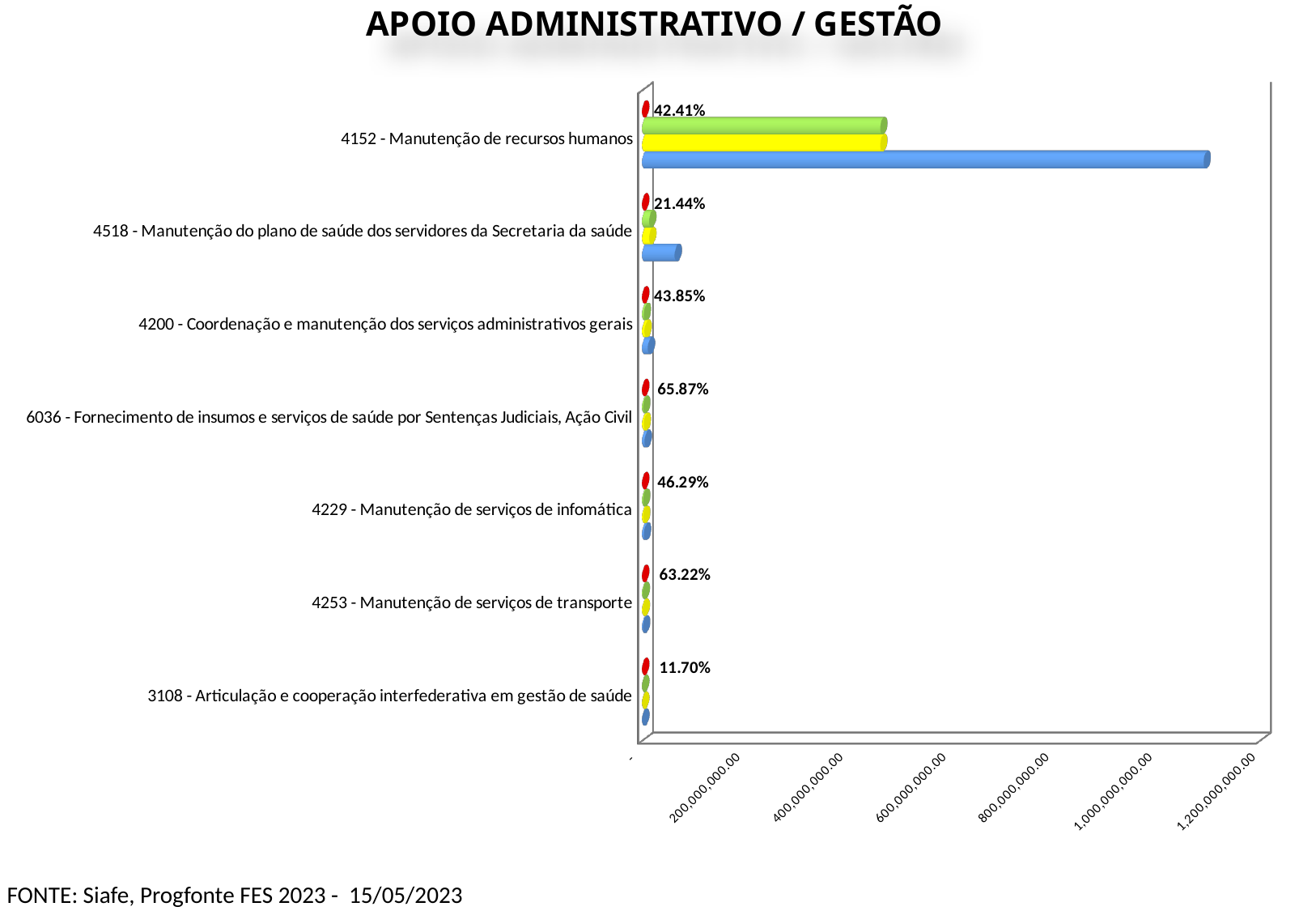
What is the difference between the percentage labels for 6036 (65.87%) and 3108 (11.70%)? 54.17% What type of chart is shown on the slide? Bar chart Is the value of the blue bar for "4518 - Manutenção do plano de saúde dos servidores da Secretaria da saúde" greater or less than 200,000,000.00? less What is the title of the chart? APOIO ADMINISTRATIVO / GESTÃO Which category has the highest percentage label? 6036 - Fornecimento de insumos e serviços de saúde por Sentenças Judiciais, Ação Civil Is the value of the longest (blue) bar for "4152 - Manutenção de recursos humanos" greater or less than 1,000,000,000.00? greater How many categories are shown on the vertical axis of the chart? 7 What percentage label is shown for "3108 - Articulação e cooperação interfederativa em gestão de saúde"? 11.70% Which category has the lowest percentage label? 3108 - Articulação e cooperação interfederativa em gestão de saúde Which has the larger percentage label: "4253 - Manutenção de serviços de transporte" or "4229 - Manutenção de serviços de infomática"? 4253 - Manutenção de serviços de transporte What percentage label is shown for "4152 - Manutenção de recursos humanos"? 42.41% What percentage label is shown for "6036 - Fornecimento de insumos e serviços de saúde por Sentenças Judiciais, Ação Civil"? 65.87%